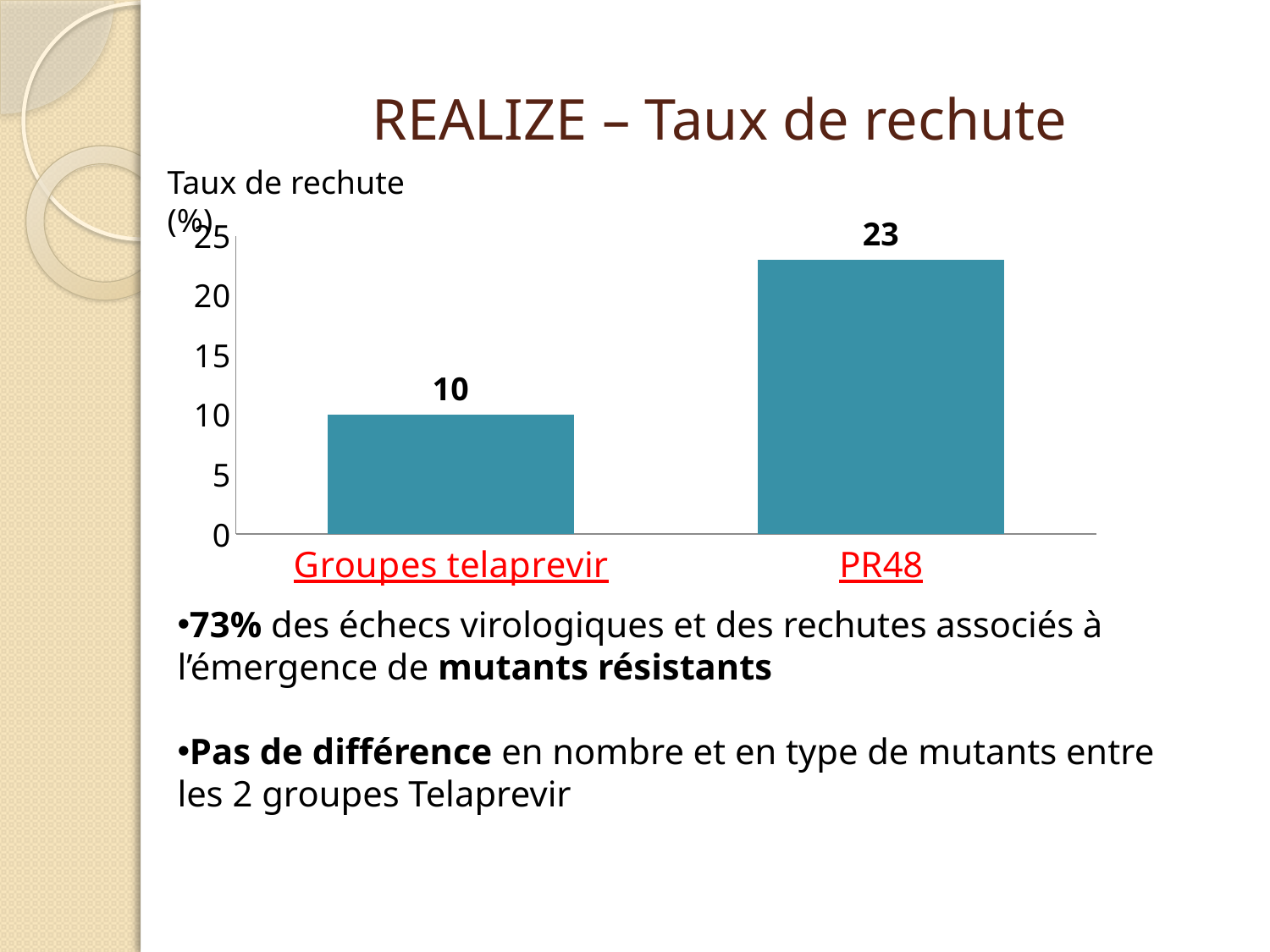
What kind of chart is shown on the slide? Bar chart Which group has the lowest relapse rate? Groupes telaprevir What is the label of the vertical axis? Taux de rechute (%) Is the value for Groupes telaprevir greater or less than 15? less Is the value for PR48 greater or less than 20? greater What is the difference between the relapse rate for PR48 and for Groupes telaprevir? 13 What is the relapse rate for PR48? 23 Which is larger, the relapse rate for Groupes telaprevir or for PR48? PR48 What is the relapse rate for Groupes telaprevir? 10 Which group has the highest relapse rate? PR48 What is the title of the slide? REALIZE – Taux de rechute How many categories are shown on the chart? 2